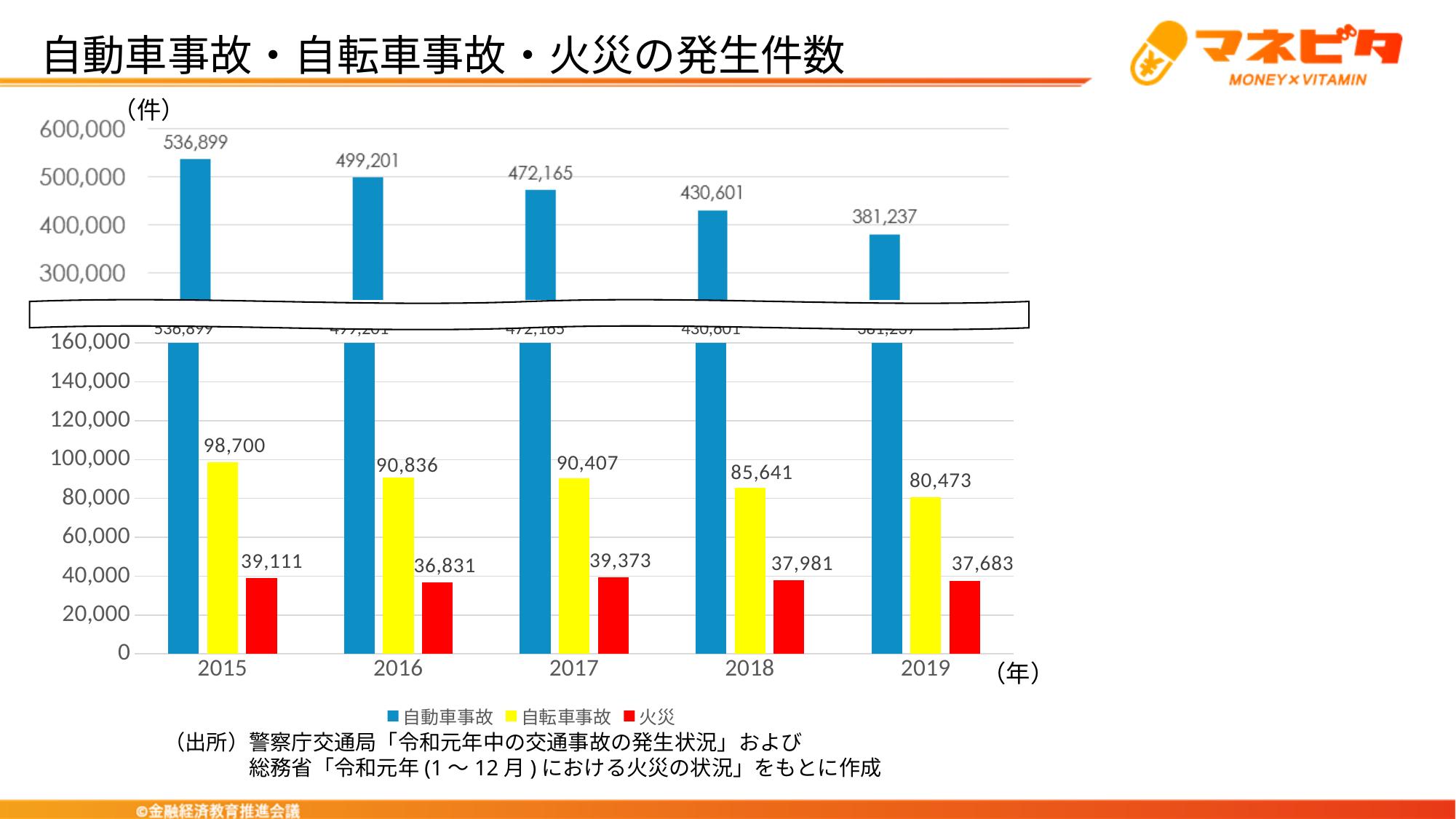
What was the number of 火災 in 2019? 37,683 In which year was the number of 自動車事故 lowest? 2019 What was the number of 自動車事故 in 2015? 536,899 Does the number of 自動車事故 rise or fall from 2015 to 2019? Fall What is the difference between the number of 自動車事故 in 2015 and in 2019? 155,662 How many series does the legend list? 3 What kind of chart is shown on the slide? Bar chart What was the number of 自転車事故 in 2017? 90,407 Which colour represents 火災 in the chart? Red Which was larger in 2018: the number of 自転車事故 or the number of 火災? 自転車事故 In which year was the number of 自転車事故 highest? 2015 How many years are shown on the x axis? 5